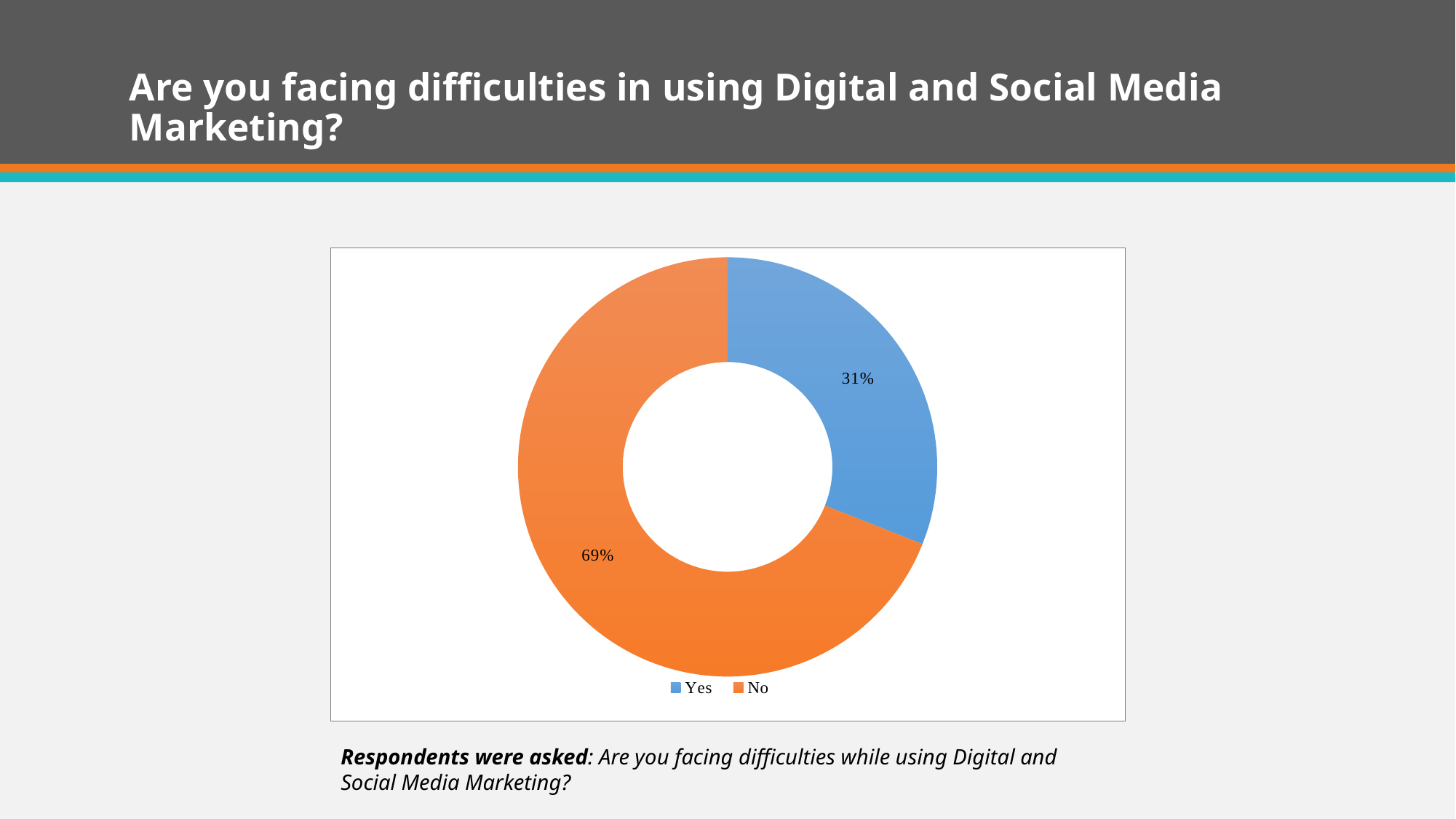
What are the two entries listed in the chart legend? Yes and No Which is larger, the share for "Yes" or the share for "No"? No What percentage of respondents answered "No"? 69% What kind of chart is shown on the slide? Doughnut (pie) chart How many categories does the chart show? 2 What colour is the "Yes" slice? Blue What percentage of respondents answered "Yes"? 31% Which response has the smallest share of the chart? Yes What share of the chart does the "No" slice represent? 69% What is the difference in percentage points between the "No" and "Yes" shares? 38 Which response has the largest share of the chart? No